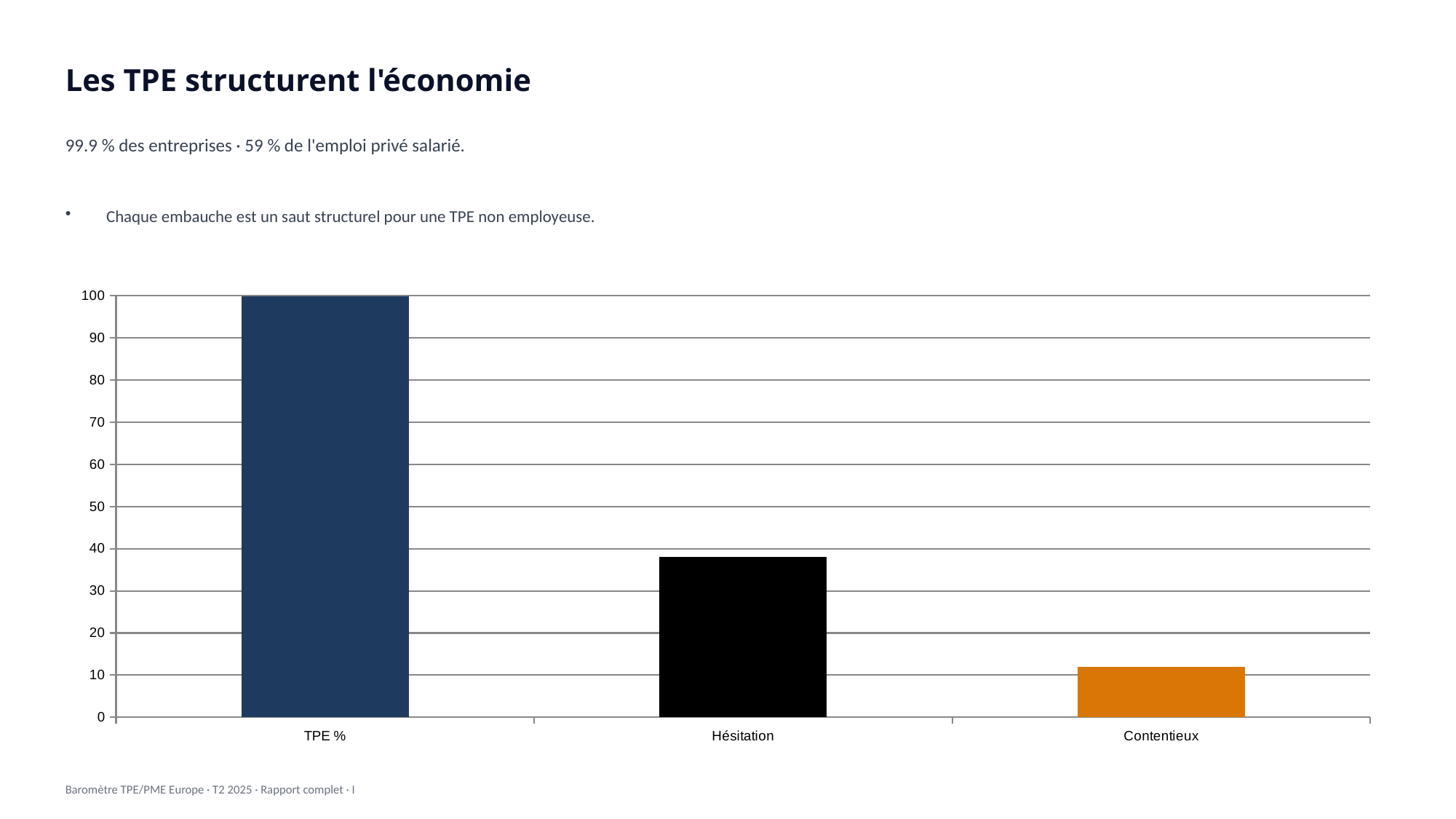
Which category has the lowest value on the chart? Contentieux Is the value for Contentieux greater or less than 20? less Is the value for Contentieux greater or less than 10? greater Which is larger, the value for Hésitation or the value for Contentieux? Hésitation Is the value for Hésitation greater or less than 40? less What colour is the bar for Contentieux? orange Which category has the highest value on the chart? TPE % Do the values rise or fall from left to right along the x axis? fall What kind of chart is shown on the slide? bar chart How many categories are plotted on the chart? 3